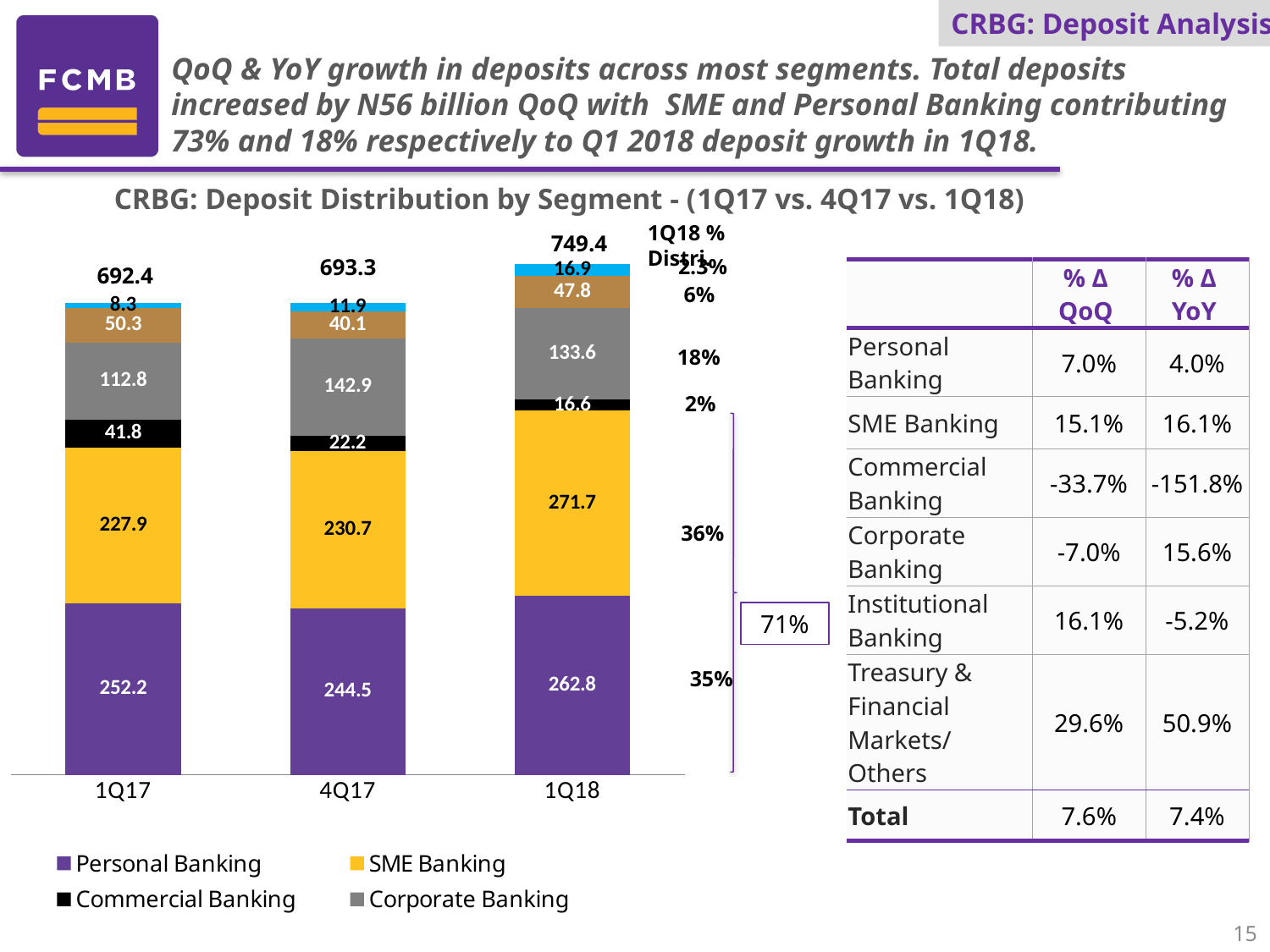
What is the Commercial Banking value for 4Q17? 22.2 What is the Personal Banking value for 1Q17? 252.2 Is the Personal Banking value larger in 1Q18 or in 4Q17? 1Q18 Which period has the highest total deposits? 1Q18 Which period has the lowest Commercial Banking value? 1Q18 What is the difference between the SME Banking values for 1Q18 and 4Q17? 41.0 How many series does the legend list? 4 What kind of chart is shown? Stacked bar chart What is the Corporate Banking value for 1Q18? 133.6 What is the SME Banking value for 4Q17? 230.7 What is the total deposit value shown for 1Q18? 749.4 How many periods are shown on the x axis? 3